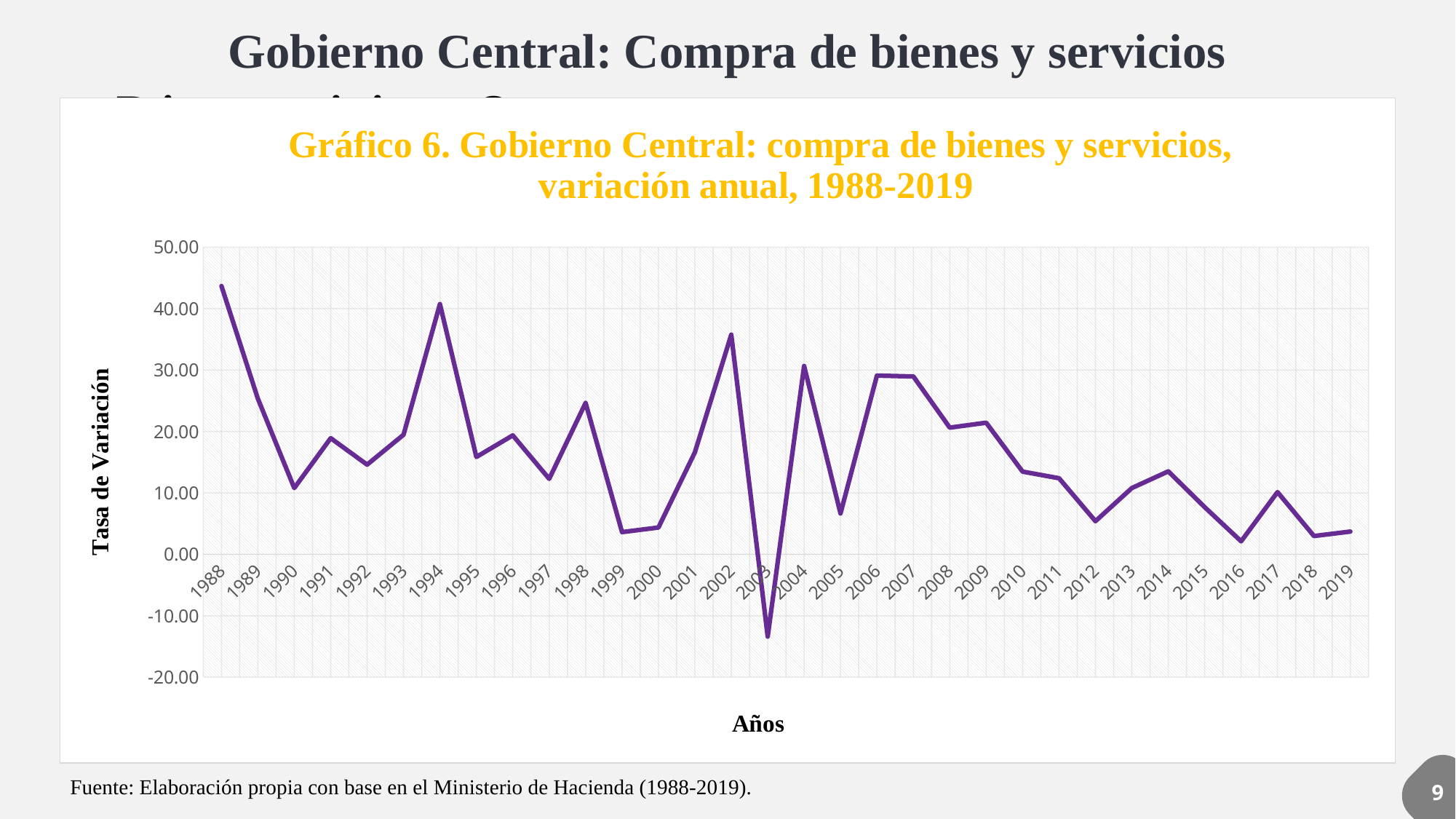
Is the value for 1998 greater or less than 20.00? greater What kind of chart is shown on the slide? line chart Is the value for 1988 greater or less than 40.00? greater How many years are plotted on the x axis of the chart? 32 Which year has the highest value in the chart? 1988 Which year has the larger value, 2002 or 2004? 2002 Is the value for 2003 greater or less than -10.00? less What is the label of the y axis of the chart? Tasa de Variación Which year has the lowest value in the chart? 2003 Do the values rise or fall from 2007 to 2012? fall